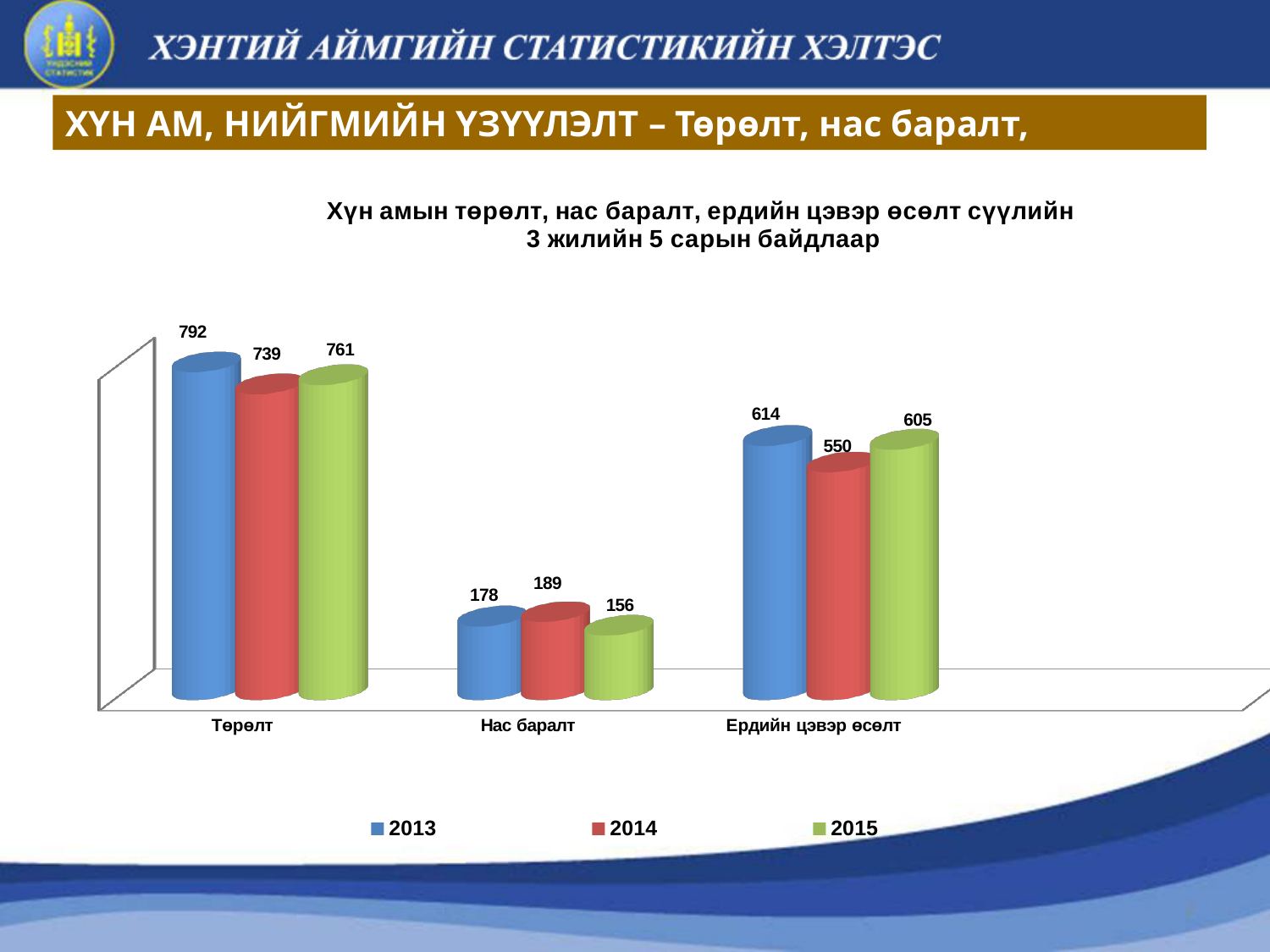
What is the value for Төрөлт in 2013? 792 How many categories are shown on the x axis? 3 Which colour represents the 2014 series in the legend? Red What is the value for Ердийн цэвэр өсөлт in 2014? 550 What is the difference between the 2013 and 2014 values for Ердийн цэвэр өсөлт? 64 What is the difference between the 2013 and 2015 values for Төрөлт? 31 How many series does the legend list? 3 Which year has the lowest value for Төрөлт? 2014 What is the value for Нас баралт in 2015? 156 Which is larger: the 2015 value for Төрөлт or the 2015 value for Ердийн цэвэр өсөлт? Төрөлт Which year has the highest value for Нас баралт? 2014 What kind of chart is shown on the slide? Bar chart